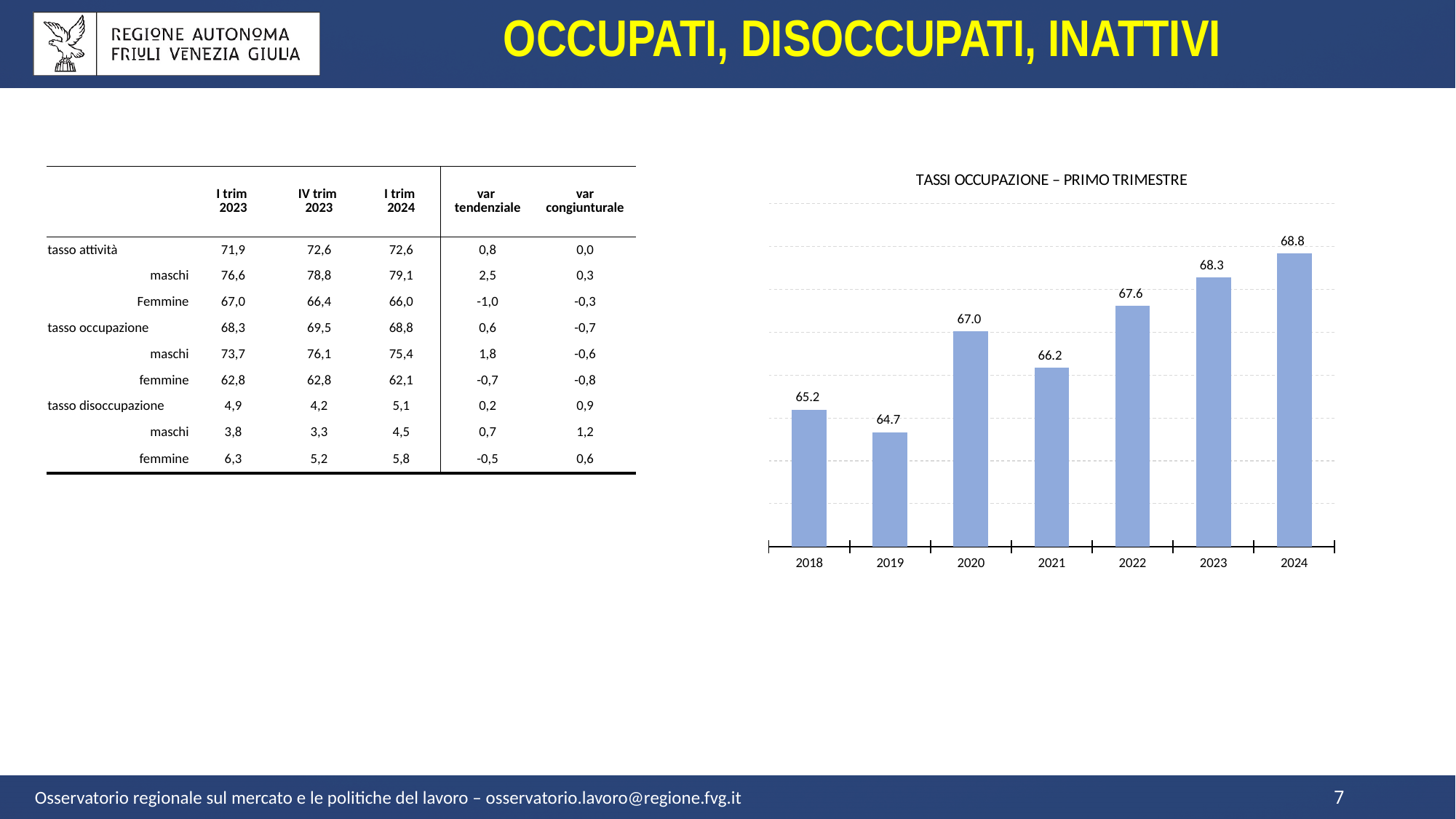
What is the title of the chart on the slide? TASSI OCCUPAZIONE – PRIMO TRIMESTRE Which year has the lowest value in the chart? 2019 What kind of chart is shown on the slide? bar chart What is the value for 2024 in the chart? 68.8 What is the difference between the values for 2020 and 2021 in the chart? 0.8 What is the value for 2020 in the chart 'TASSI OCCUPAZIONE – PRIMO TRIMESTRE'? 67.0 What is the value for 2018 in the chart? 65.2 Which year has the highest value in the chart? 2024 Which is larger in the chart, the value for 2020 or the value for 2021? 2020 How many years are shown in the chart? 7 Does the value rise or fall from 2021 to 2024 in the chart? rise What is the difference between the values for 2024 and 2018 in the chart? 3.6